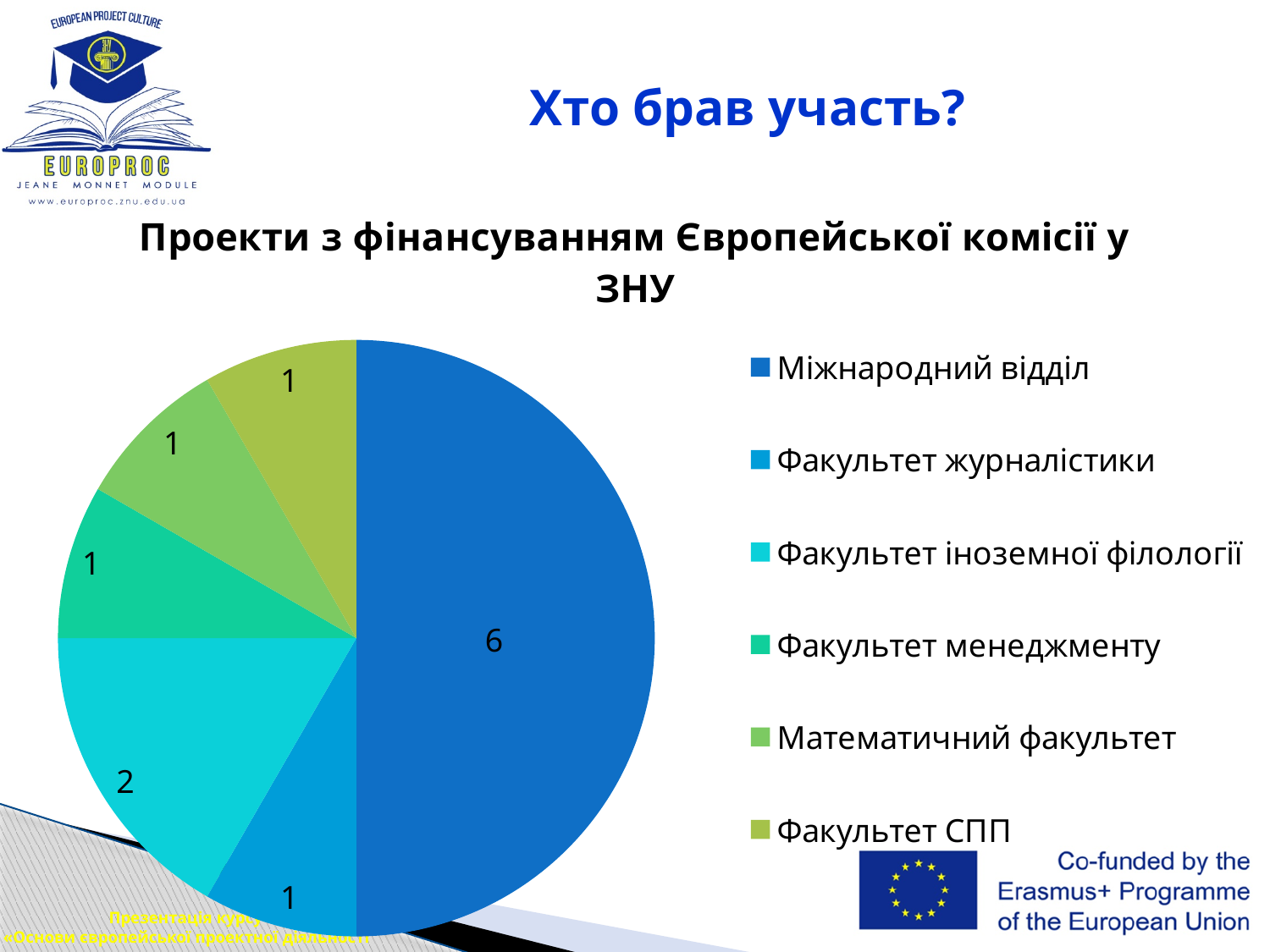
What is the title of the chart? Проекти з фінансуванням Європейської комісії у ЗНУ What is the value for Міжнародний відділ? 6 What is the value for Факультет іноземної філології? 2 What share of the pie does Міжнародний відділ represent? 50% Which legend entry is listed last? Факультет СПП How many categories does the pie chart have? 6 What is the value for Факультет журналістики? 1 What is the total of all slices in the pie chart? 12 What is the difference between the values for Міжнародний відділ and Факультет іноземної філології? 4 Which is larger: the value for Факультет іноземної філології or the value for Факультет менеджменту? Факультет іноземної філології Which category has the largest slice of the pie? Міжнародний відділ What type of chart is shown on the slide? pie chart